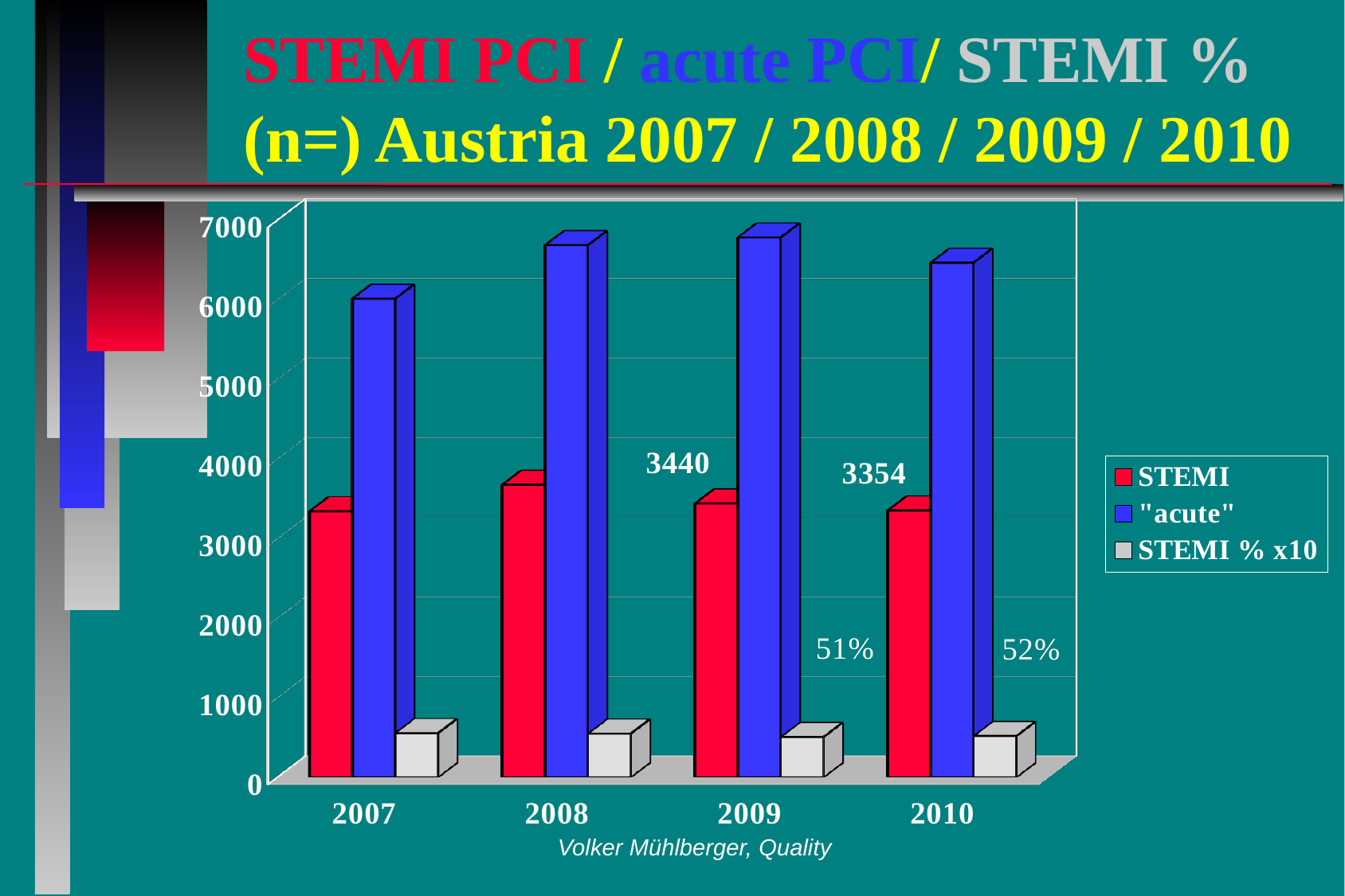
In which year is the "acute" bar lowest? 2007 What STEMI percentage is shown for 2010? 52% Is the "acute" value for 2007 greater or less than 5000? greater What is the STEMI value for 2010? 3354 What are the three legend entries? STEMI, "acute", STEMI % x10 In 2007, which is larger, the STEMI bar or the "acute" bar? "acute" How many years are shown on the x axis? 4 What kind of chart is shown on the slide? bar chart How many series does the legend list? 3 What is the difference between the STEMI values for 2009 and 2010? 86 What is the STEMI value for 2009? 3440 What STEMI percentage is shown for 2009? 51%